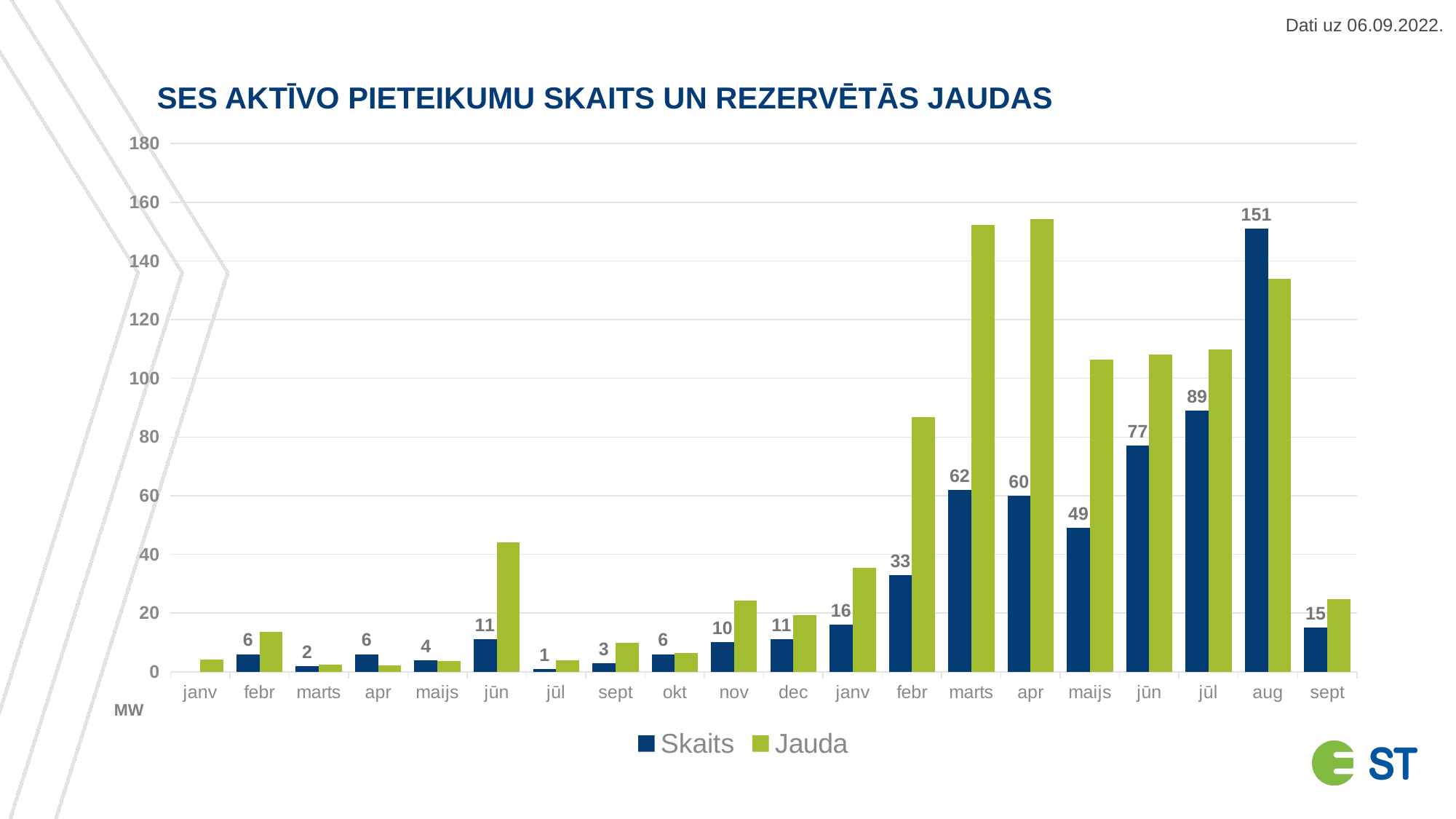
What kind of chart is shown on the slide? bar chart What is the Skaits value for aug? 151 Which has the larger Skaits value: the second marts or the second apr on the x axis? marts How many series does the legend list? 2 What is the difference between the Skaits values for the second jūl and the second jūn on the x axis? 12 Is the Jauda value for aug greater or less than 140? less What are the two series names listed in the legend? Skaits and Jauda What is the Skaits value for the first jūn on the x axis? 11 What is the Skaits value for the second jūn on the x axis? 77 Is the Jauda value for the second apr on the x axis greater or less than 140? greater How many month categories are shown on the x axis? 20 Which month has the highest Skaits value? aug